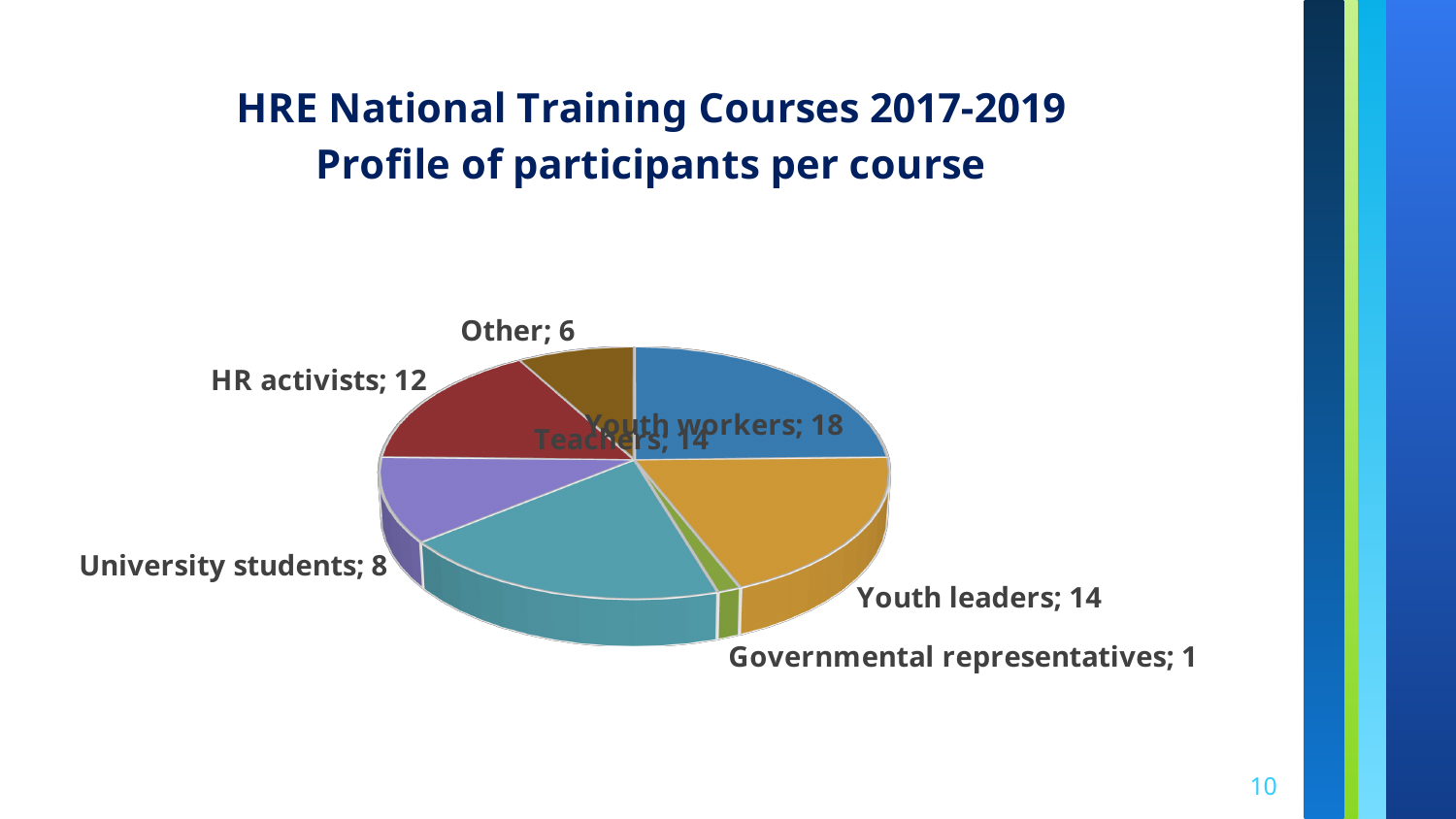
What is the value for University students? 8 What kind of chart is shown on the slide? pie chart Which is larger, the value for HR activists or the value for University students? HR activists Which category has the lowest value? Governmental representatives How many participants per course are Youth workers? 18 How many categories does the pie chart show? 7 Which category has the highest value? Youth workers What is the value for Governmental representatives? 1 What is the difference between the values for Youth leaders and Other? 8 What is the title of the chart? HRE National Training Courses 2017-2019 Profile of participants per course What is the difference between the values for Youth workers and HR activists? 6 What is the value for HR activists? 12